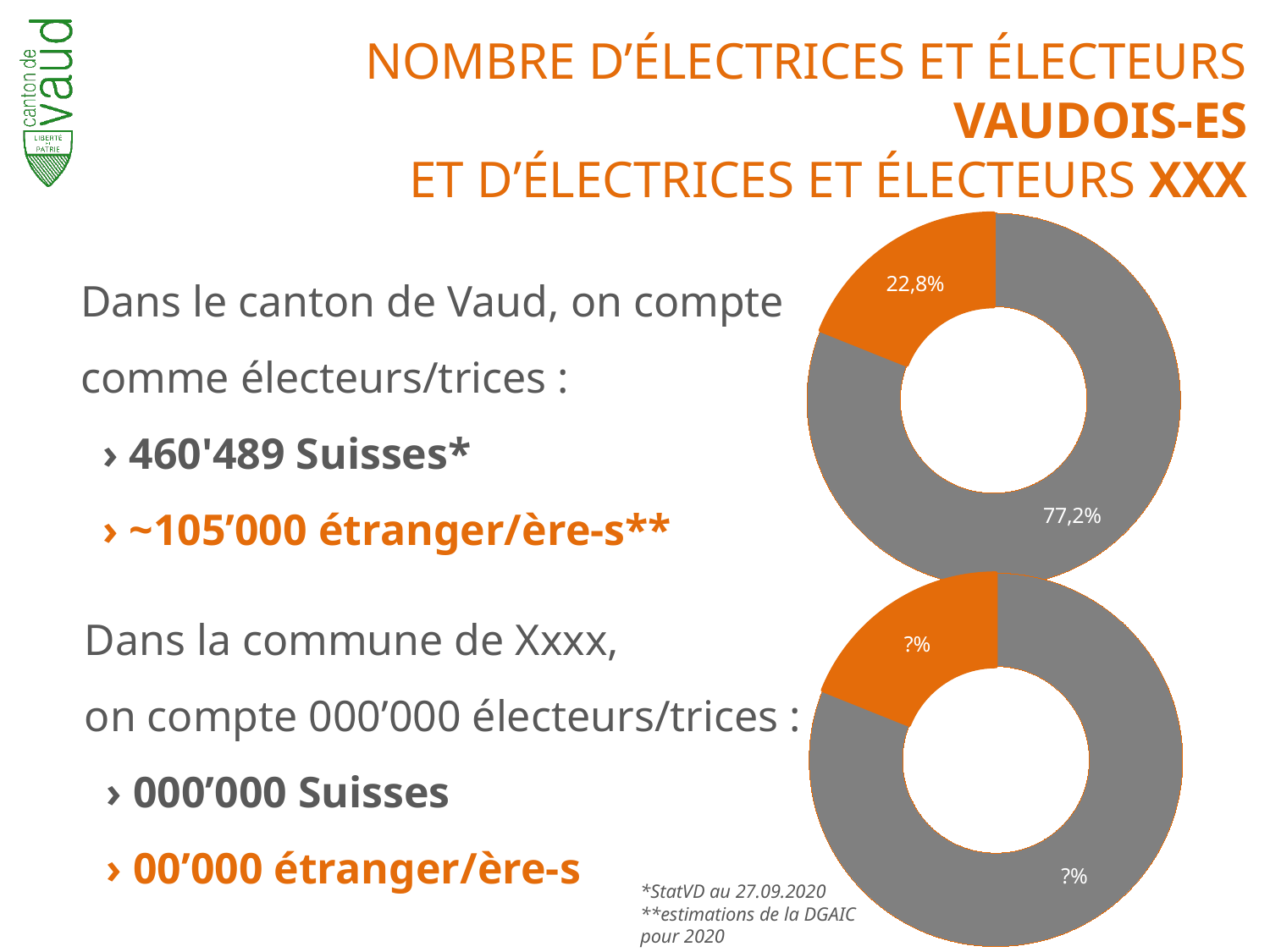
In the bottom doughnut chart, what label is shown on the grey slice? ?% In the top doughnut chart, what percentage is shown on the orange slice? 22,8% In the bottom doughnut chart, what label is shown on the orange slice? ?% In the top doughnut chart, what percentage is shown on the grey slice? 77,2% What two colours are used for the slices in the doughnut charts? Orange and grey How many slices does the top doughnut chart have? 2 How many slices does the bottom doughnut chart have? 2 How many doughnut charts are on the slide? 2 In the top doughnut chart, which slice is larger, the grey one or the orange one? The grey one In the bottom doughnut chart, which slice is larger, the grey one or the orange one? The grey one What kind of chart is shown at the top right of the slide? Doughnut (pie) chart In the top doughnut chart, what is the difference between the grey slice's share and the orange slice's share? 54,4 percentage points